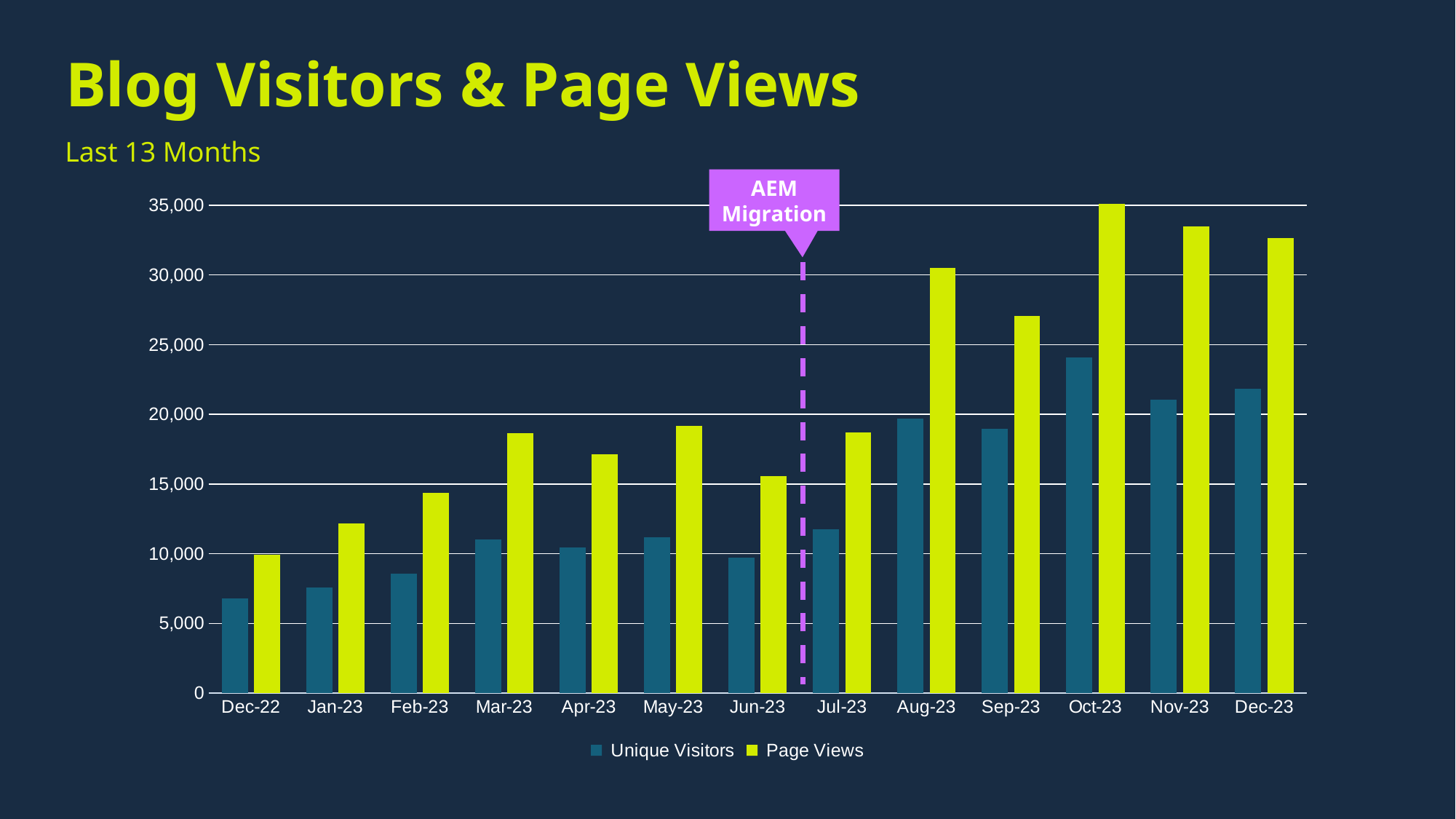
Is the Page Views value for Jan-23 greater or less than 10,000? greater How many months are shown on the x axis of the chart? 13 What kind of chart is shown on the slide? Bar chart What event does the annotation above the dashed line between Jun-23 and Jul-23 mark? AEM Migration Is the Unique Visitors value for Oct-23 greater or less than 25,000? less Which month has the highest Page Views? Oct-23 Do Page Views generally rise or fall from Dec-22 to Dec-23? Rise Is the Page Views value for Sep-23 greater or less than 25,000? greater How many series does the chart's legend list? 2 Which month has the lowest Page Views? Dec-22 Which month has higher Page Views, Mar-23 or Apr-23? Mar-23 Which month has the highest Unique Visitors? Oct-23